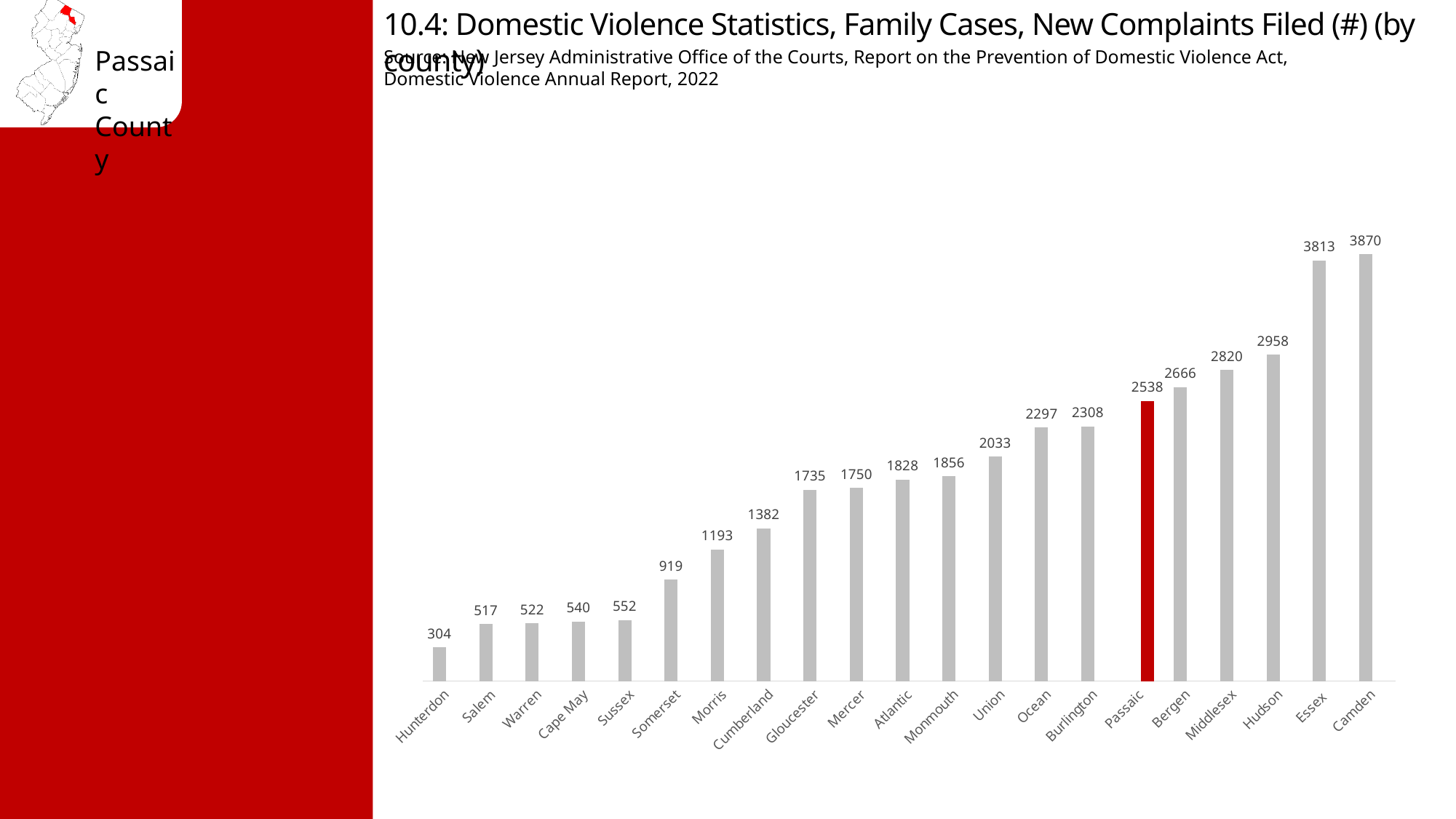
Which county has the highest number of new complaints filed? Camden Which county's bar is highlighted in red? Passaic What is the value shown for Middlesex? 2820 Which has a larger value, Hudson or Middlesex? Hudson Which county has the lowest number of new complaints filed? Hunterdon What is the value shown for Hunterdon? 304 What kind of chart is shown on the slide? Bar chart What is the difference between the values for Passaic and Bergen? 128 What is the number of new domestic violence complaints filed in Passaic County? 2538 How many counties are shown on the chart? 21 What is the difference between the values for Camden and Essex? 57 Which has a larger value, Somerset or Morris? Morris